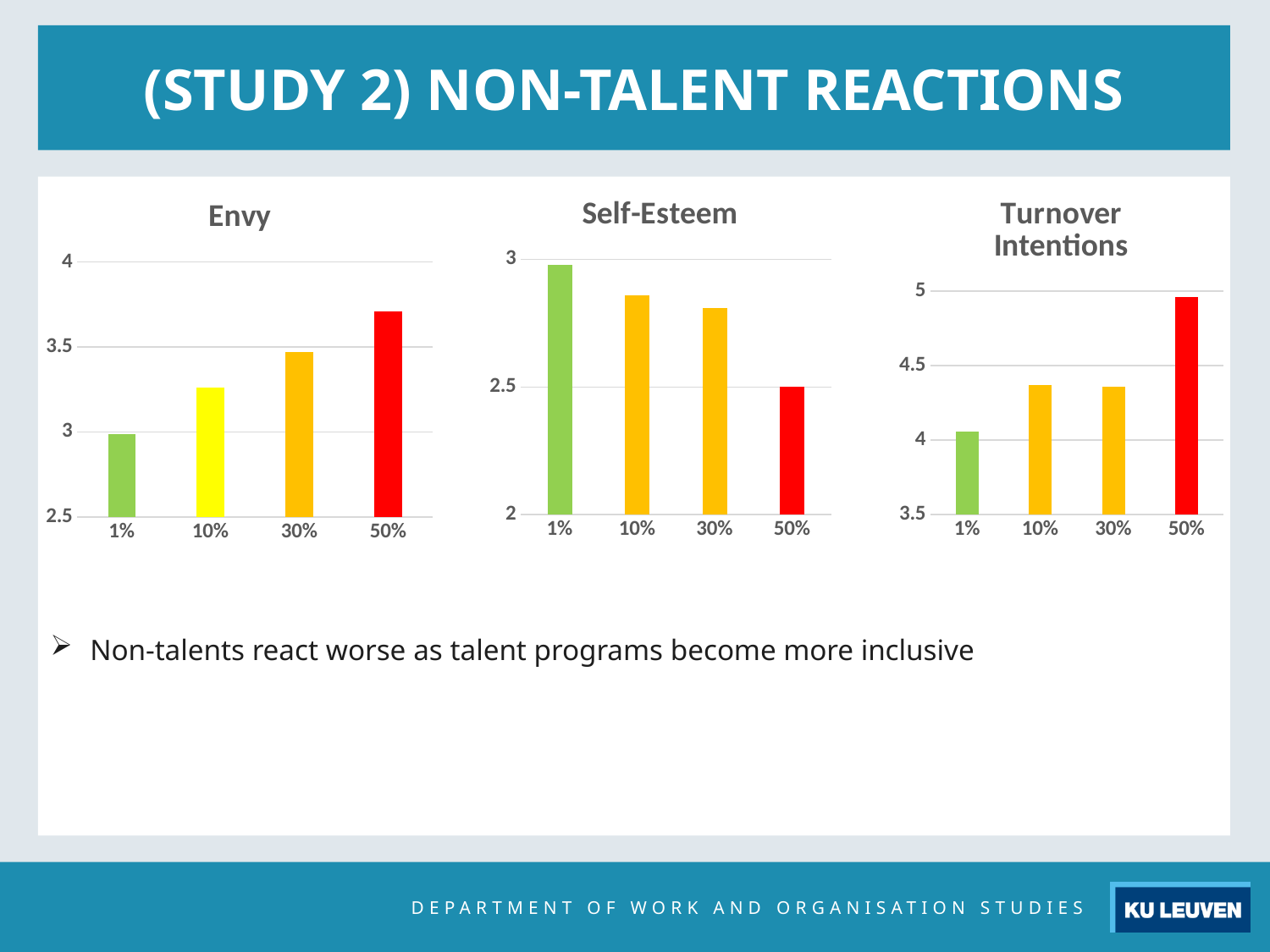
What kind of chart is the Envy chart? bar chart In the Self-Esteem chart, do the values rise or fall from 1% to 50%? fall In the Turnover Intentions chart, which is larger, the value for 50% or the value for 1%? 50% In the Turnover Intentions chart, which category has the highest value? 50% In the Turnover Intentions chart, is the value for 1% greater or less than 4.5? less In the Self-Esteem chart, which category has the highest value? 1% In the Envy chart, which category has the lowest value? 1% In the Self-Esteem chart, which category has the lowest value? 50% In the Envy chart, which category has the highest value? 50% How many categories are shown on the x axis of the Self-Esteem chart? 4 In the Envy chart, is the value for 50% greater or less than 3.5? greater In the Envy chart, do the values rise or fall from 1% to 50%? rise